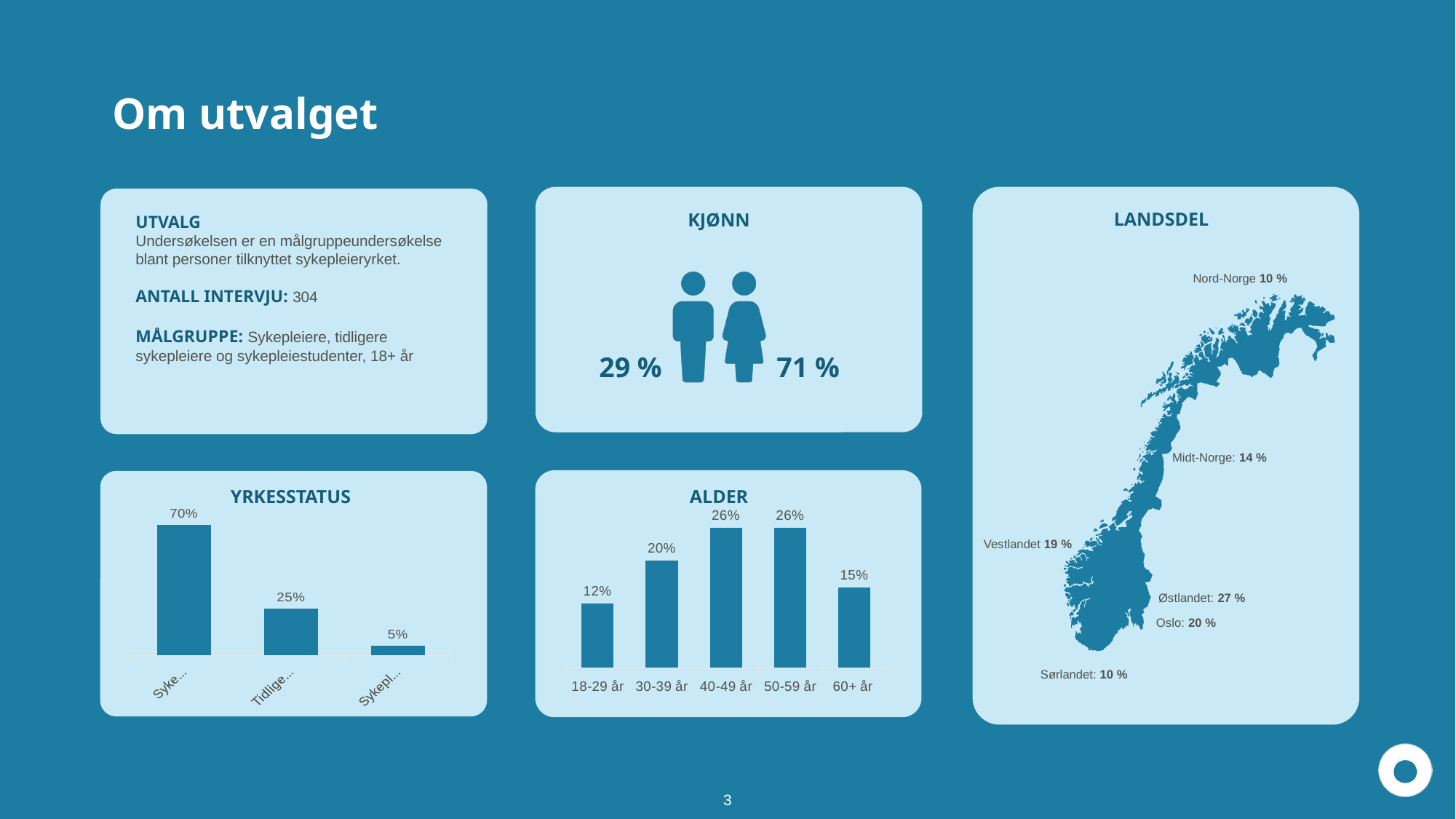
In the ALDER chart, what is the value for 30-39 år? 20% In the ALDER chart, which age group has the lowest value? 18-29 år In the ALDER chart, which is larger, the value for 30-39 år or the value for 60+ år? 30-39 år In the ALDER chart, what is the difference between the values for 30-39 år and 18-29 år? 8% What kind of chart is the ALDER chart? bar chart How many bars are shown in the YRKESSTATUS chart? 3 How many age groups are shown in the ALDER chart? 5 In the ALDER chart, what is the value for 18-29 år? 12% In the ALDER chart, what is the value for 60+ år? 15% In the YRKESSTATUS chart, what is the value of the tallest bar? 70% In the YRKESSTATUS chart, what is the difference between the first bar and the second bar? 45% In the YRKESSTATUS chart, what is the value of the shortest bar? 5%